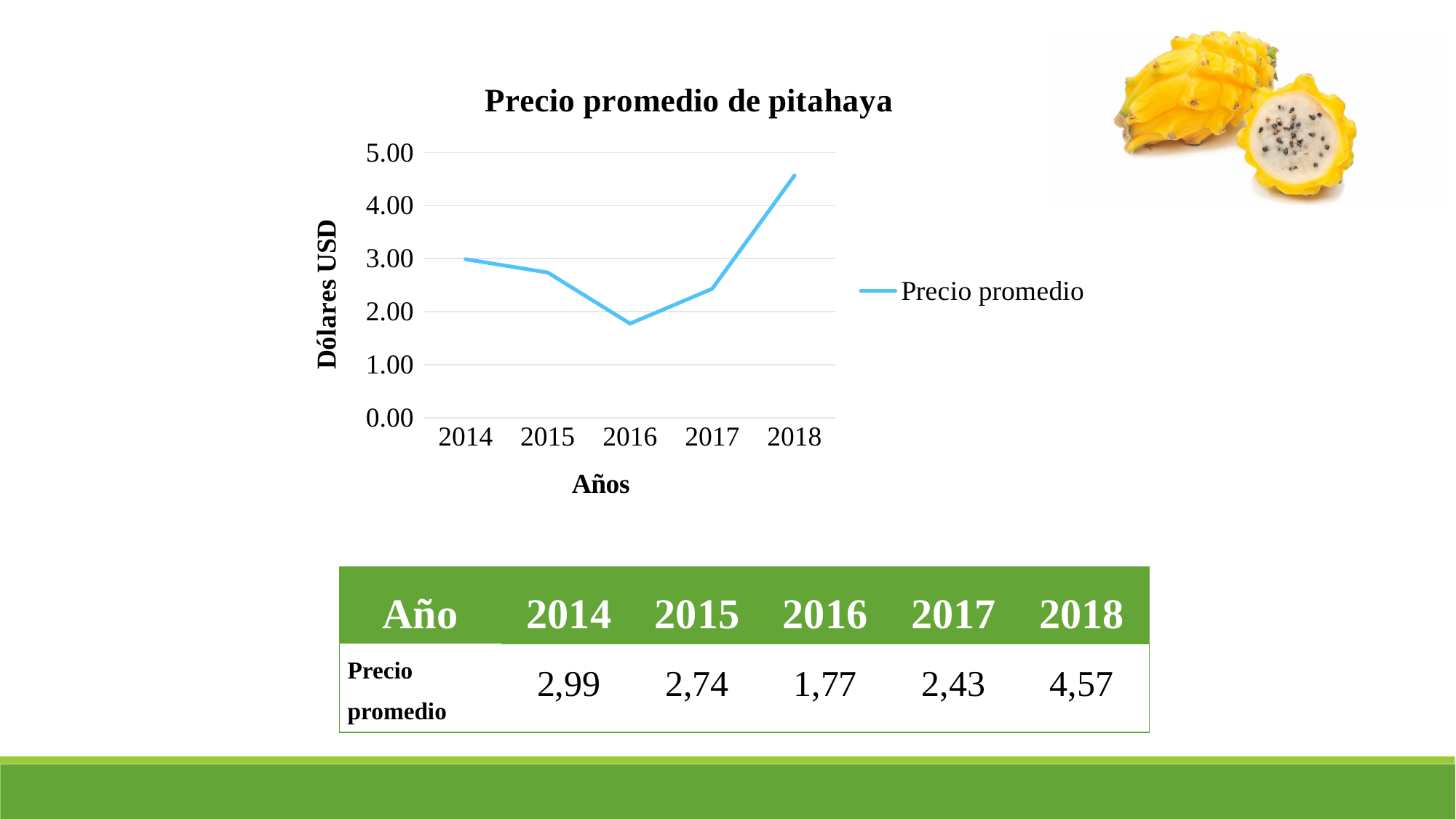
How many years are plotted on the x axis of the chart? 5 What is the title of the chart? Precio promedio de pitahaya What type of chart is shown on the slide? line chart Is the value for 2018 greater or less than 4.00? greater What is the average price of pitahaya in 2018? 4,57 What is the average price of pitahaya in 2016? 1,77 Which year has a higher average price, 2014 or 2015? 2014 Which year has the highest average price? 2018 Which year has the lowest average price? 2016 What is the difference between the average price in 2018 and in 2017? 2,14 How many series does the chart legend list? 1 Does the average price rise or fall from 2014 to 2016? fall